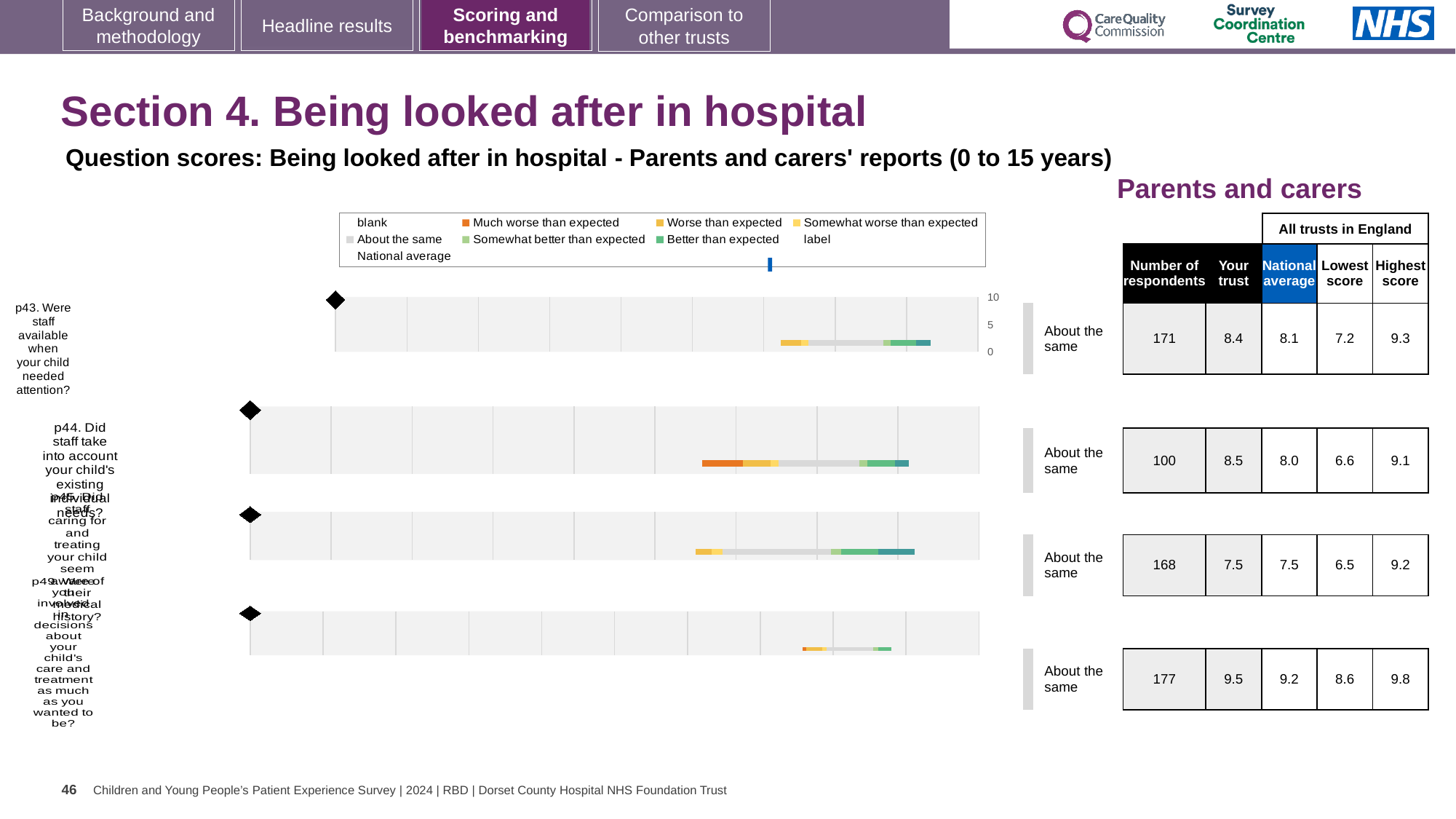
For question p43, which is larger: the 'Your trust' score or the national average? Your trust (8.4 vs 8.1) Which of the four questions has the highest 'Your trust' score? The bottom (fourth) question, with 9.5 What is the lowest score across all trusts in England for the second question from the top? 6.6 What benchmark category is shown for question p43? About the same For question p43 (Were staff available when your child needed attention?), how many respondents are shown in the table? 171 What is the highest score across all trusts in England for the bottom (fourth) question on the slide? 9.8 How many questions (charts) are shown on the slide? 4 What is the 'Your trust' score for question p43 (Were staff available when your child needed attention?)? 8.4 For question p43, how much higher is the 'Your trust' score than the national average? 0.3 What kind of chart is used to show the question scores on this slide? Bar chart What is the national average score for question p43 (Were staff available when your child needed attention?)? 8.1 Which of the four questions has the lowest 'Your trust' score? The third question from the top, with 7.5